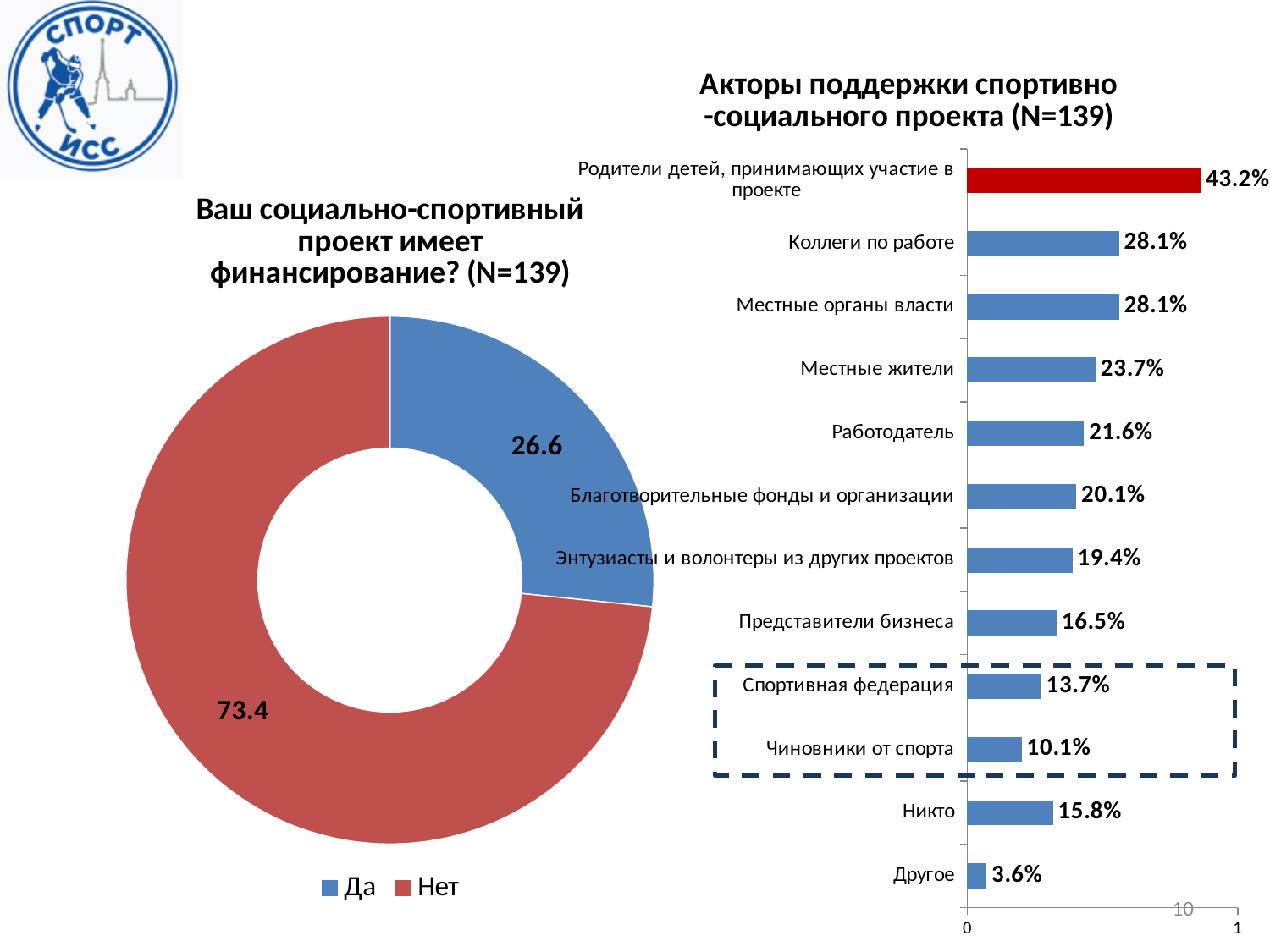
How many categories are shown in the chart 'Акторы поддержки спортивно-социального проекта (N=139)'? 12 How many entries does the legend of the chart 'Ваш социально-спортивный проект имеет финансирование? (N=139)' list? 2 In the chart 'Акторы поддержки спортивно-социального проекта (N=139)', what is the difference between 'Местные жители' and 'Работодатель'? 2.1% In the chart 'Ваш социально-спортивный проект имеет финансирование? (N=139)', what is the value for 'Да'? 26.6 In the chart 'Акторы поддержки спортивно-социального проекта (N=139)', what is the value for 'Чиновники от спорта'? 10.1% In the chart 'Ваш социально-спортивный проект имеет финансирование? (N=139)', what is the value for 'Нет'? 73.4 In the chart 'Акторы поддержки спортивно-социального проекта (N=139)', which is larger: 'Спортивная федерация' or 'Никто'? Никто In the chart 'Акторы поддержки спортивно-социального проекта (N=139)', what is the value for 'Родители детей, принимающих участие в проекте'? 43.2% In the chart 'Акторы поддержки спортивно-социального проекта (N=139)', which category has the highest value? Родители детей, принимающих участие в проекте In the chart 'Акторы поддержки спортивно-социального проекта (N=139)', which category has the lowest value? Другое What type of chart is 'Ваш социально-спортивный проект имеет финансирование? (N=139)'? Doughnut chart What type of chart is 'Акторы поддержки спортивно-социального проекта (N=139)'? Bar chart